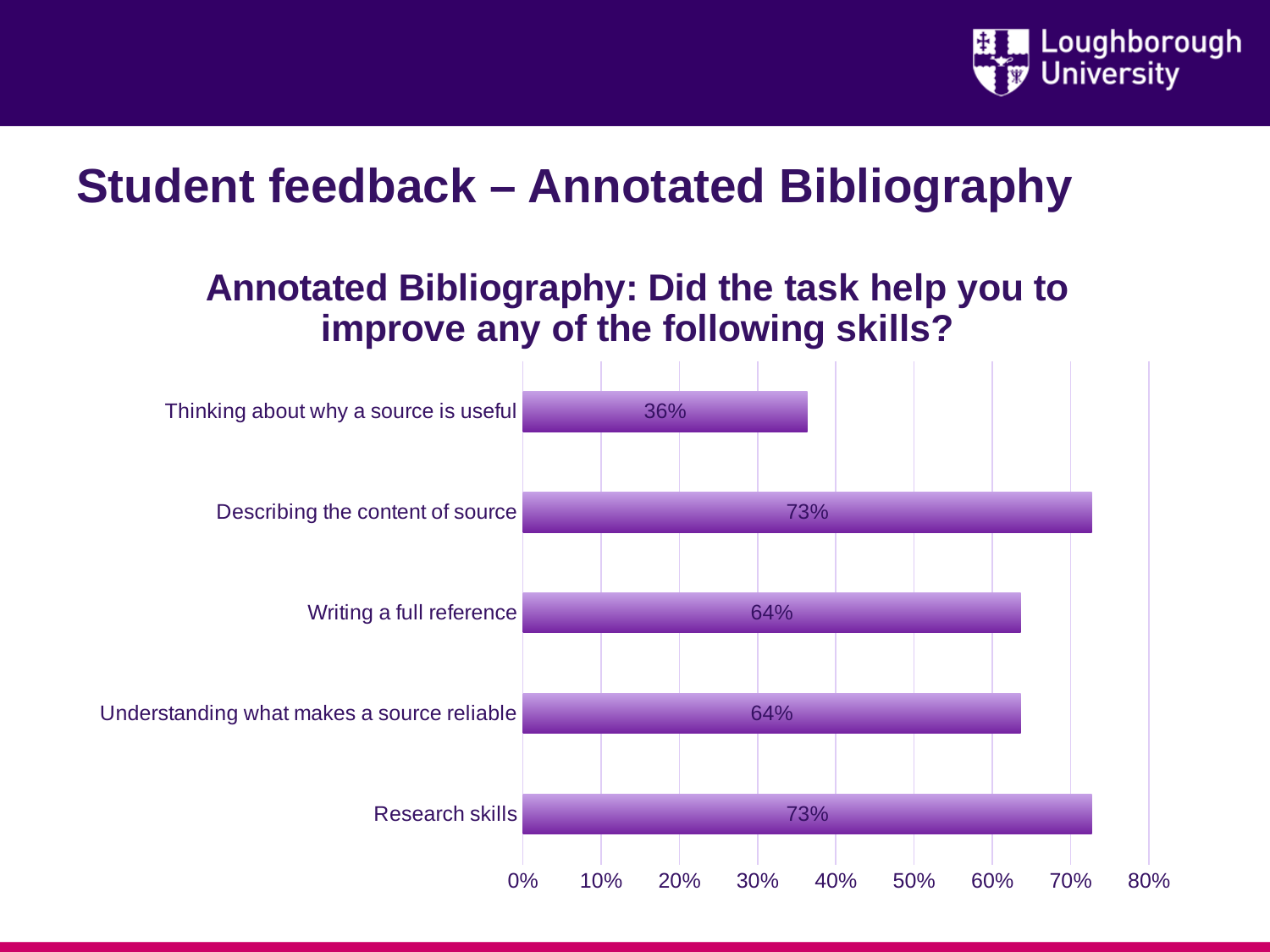
What is the highest value shown on the horizontal axis? 80% What is the difference in percentage points between 'Describing the content of source' and 'Thinking about why a source is useful'? 37 percentage points What is the value for 'Research skills'? 73% Is the value for 'Understanding what makes a source reliable' greater or less than 50%? greater What percentage is shown for 'Writing a full reference'? 64% Which skill has the lowest percentage in the chart? Thinking about why a source is useful Which has a higher value: 'Writing a full reference' or 'Research skills'? Research skills What kind of chart is shown on the slide? Bar chart What percentage of students said the task helped them improve 'Thinking about why a source is useful'? 36% What is the title of the chart? Annotated Bibliography: Did the task help you to improve any of the following skills? What is the value shown for 'Describing the content of source'? 73% How many skills are listed in the chart? 5